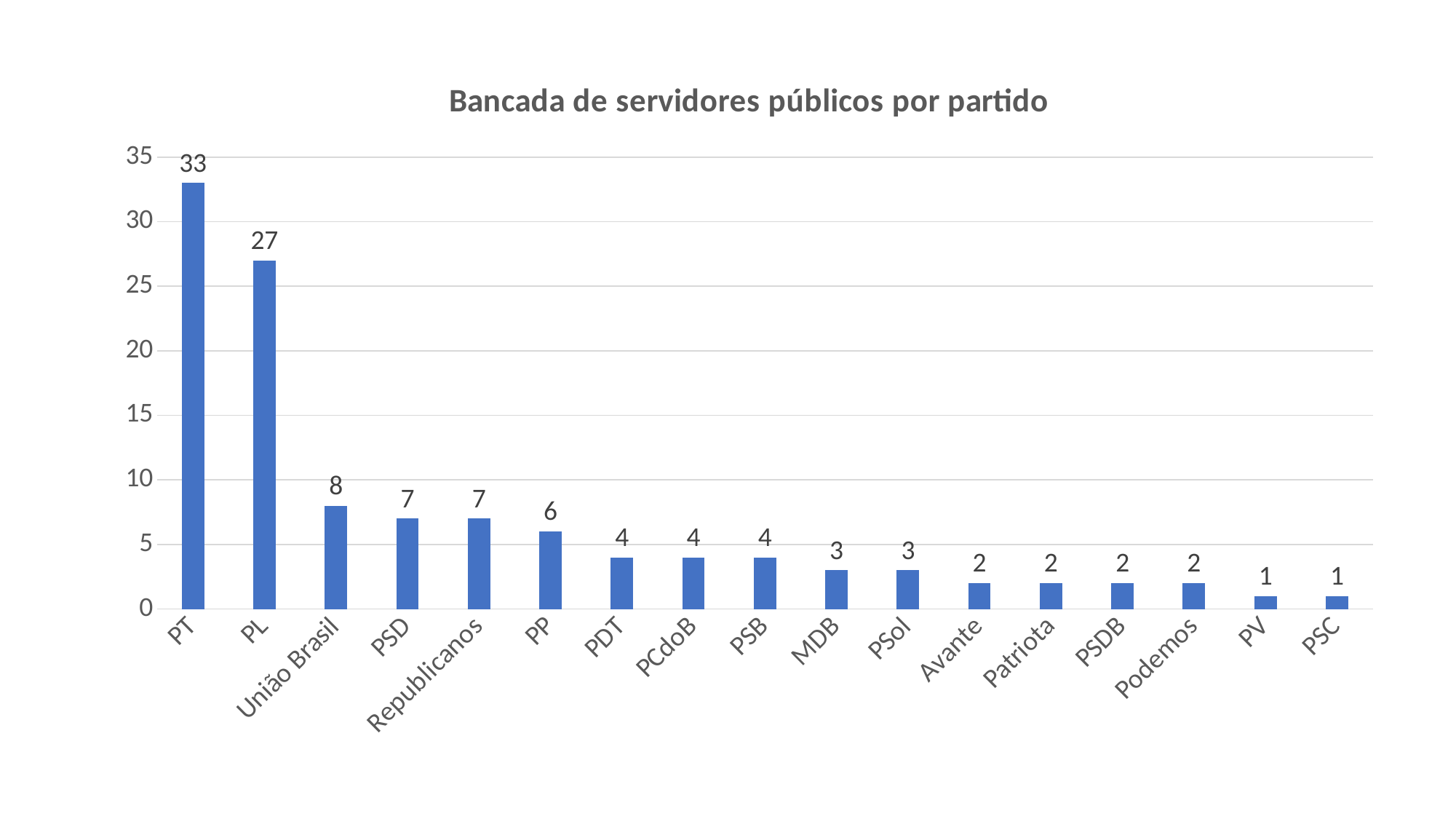
What is the value for MDB? 3 What kind of chart is this? Bar chart What is the title of the chart? Bancada de servidores públicos por partido What is the difference between the values for União Brasil and PP? 2 Which is larger, the value for PSD or the value for PDT? PSD Do the values rise or fall from left to right along the x axis? Fall What is the value for União Brasil? 8 Which party has the highest value? PT Is the value for PL greater or less than 25? greater How many parties are shown on the x axis? 17 What is the value for PT? 33 What is the difference between the values for PT and PL? 6